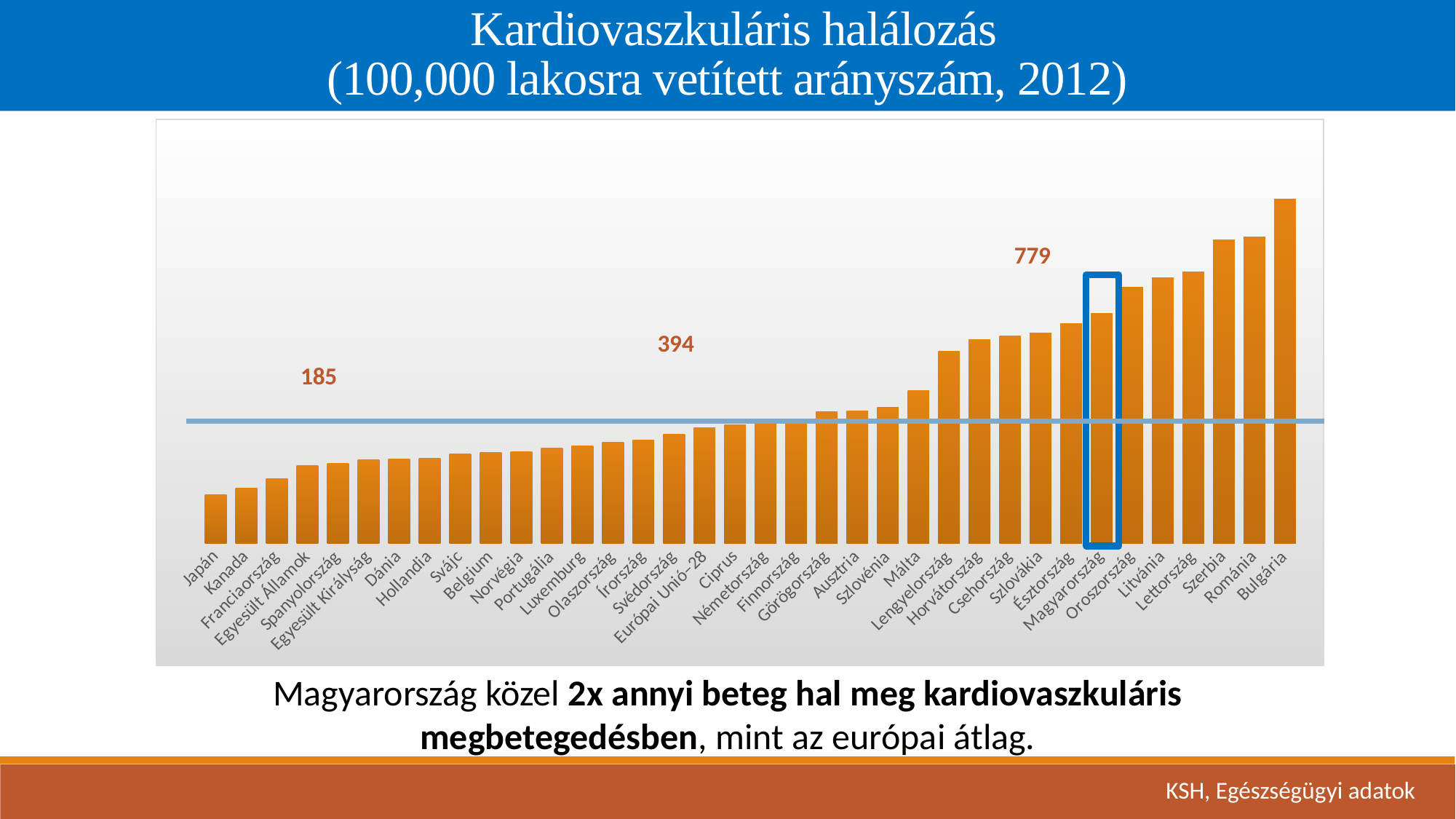
Which country has the lowest cardiovascular mortality rate in the chart? Japán What year does the chart title say the data refers to? 2012 What kind of chart is shown on the slide? bar chart What is the value labelled for Magyarország? 779 Do the bar values rise or fall from left to right along the x axis? rise Which country's bar is highlighted with a blue rectangle? Magyarország Which has a higher value, Kanada or Oroszország? Oroszország What is the value labelled for Európai Unió-28? 394 Which has a higher value, Románia or Lengyelország? Románia Which country has the highest cardiovascular mortality rate in the chart? Bulgária How many countries/categories are shown on the x axis? 36 What is the difference between the value for Magyarország (779) and the value for Európai Unió-28 (394)? 385